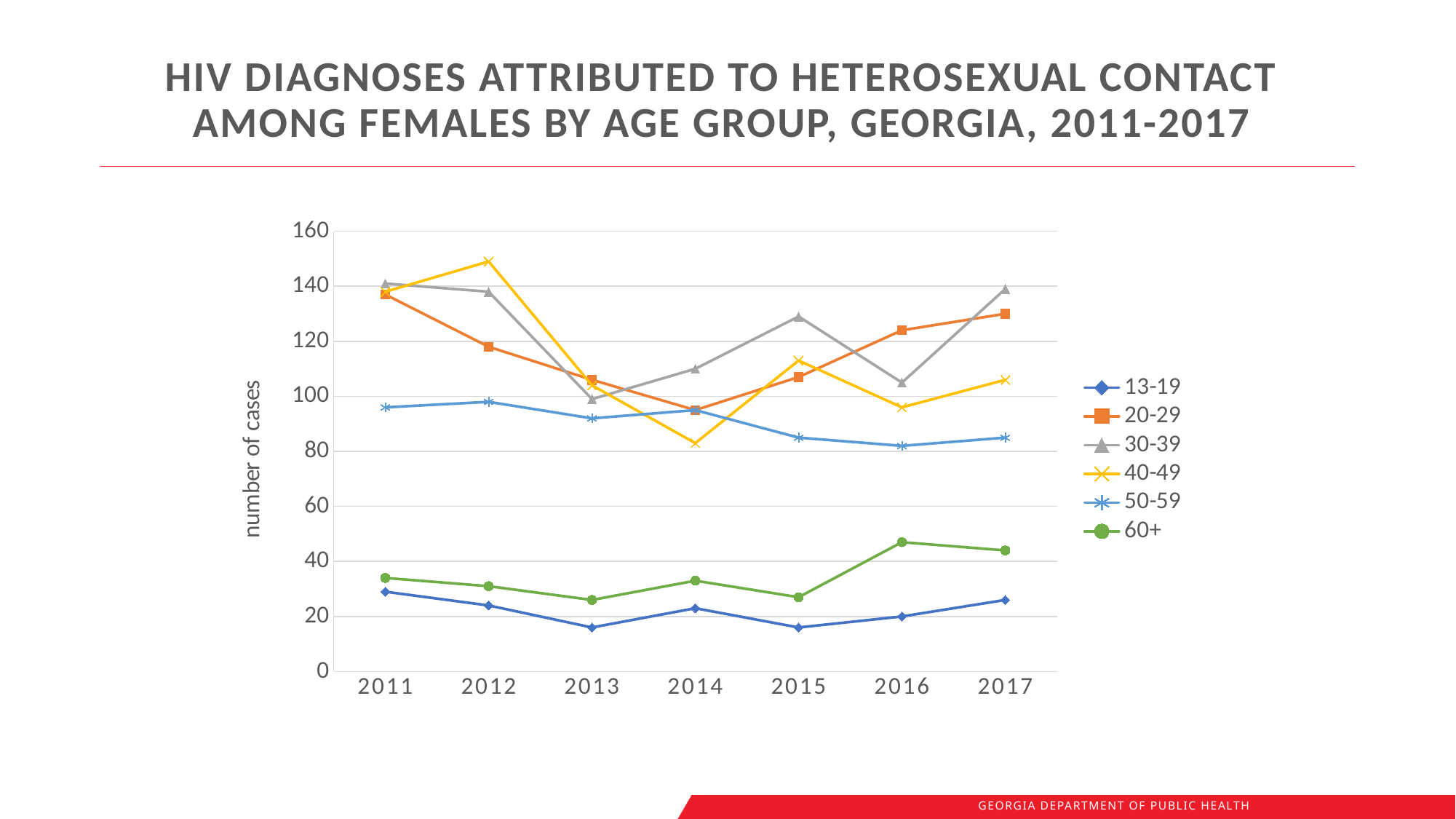
Which age group had the highest number of cases in 2017? 30-39 Which age group had the highest number of cases in 2012? 40-49 Is the value for the 60+ age group in 2016 greater or less than 40? greater Is the value for the 13-19 age group in 2013 greater or less than 20? less How many age-group series does the legend list? 6 What type of chart is shown on the slide? line chart Is the value for the 40-49 age group in 2014 greater or less than 100? less Is the 50-59 line lower or higher in 2017 than in 2011? lower How many years are shown along the x axis? 7 Which age group had the lowest number of cases in 2017? 13-19 What is the label on the y axis? number of cases